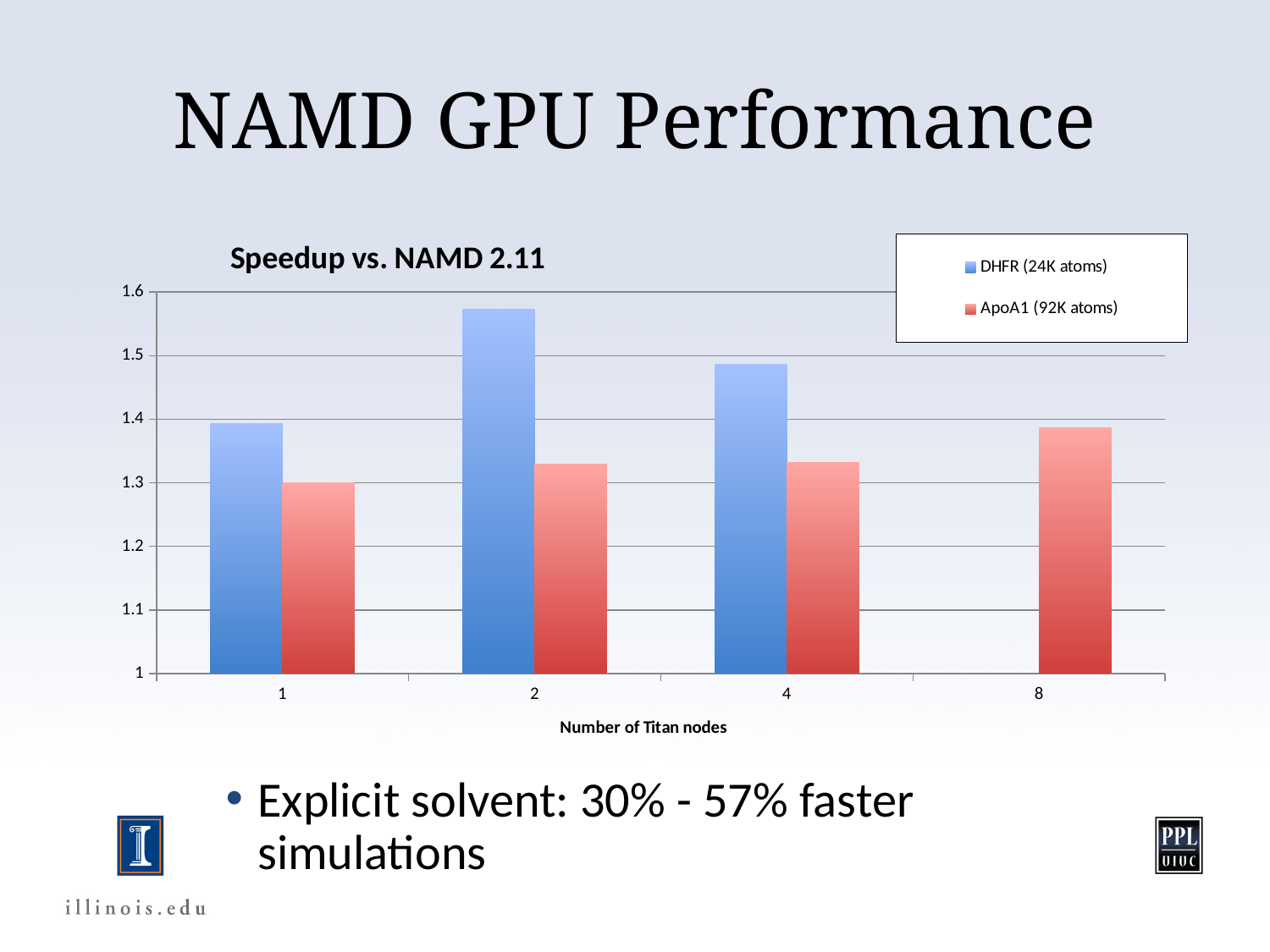
What is the title of the chart? Speedup vs. NAMD 2.11 How many categories (numbers of Titan nodes) are shown on the x axis? 4 What kind of chart is shown on the slide? Bar chart Is the DHFR (24K atoms) speedup at 2 Titan nodes greater or less than 1.5? greater Is the DHFR (24K atoms) speedup at 4 Titan nodes greater or less than 1.4? greater At 2 Titan nodes, which series has the larger speedup, DHFR (24K atoms) or ApoA1 (92K atoms)? DHFR (24K atoms) What is the label of the x axis? Number of Titan nodes At 1 Titan node, which series has the larger speedup, DHFR (24K atoms) or ApoA1 (92K atoms)? DHFR (24K atoms) How many series does the chart legend list? 2 At which number of Titan nodes is the DHFR (24K atoms) speedup highest? 2 At which number of Titan nodes is the ApoA1 (92K atoms) speedup highest? 8 Is the ApoA1 (92K atoms) speedup at 2 Titan nodes greater or less than 1.4? less